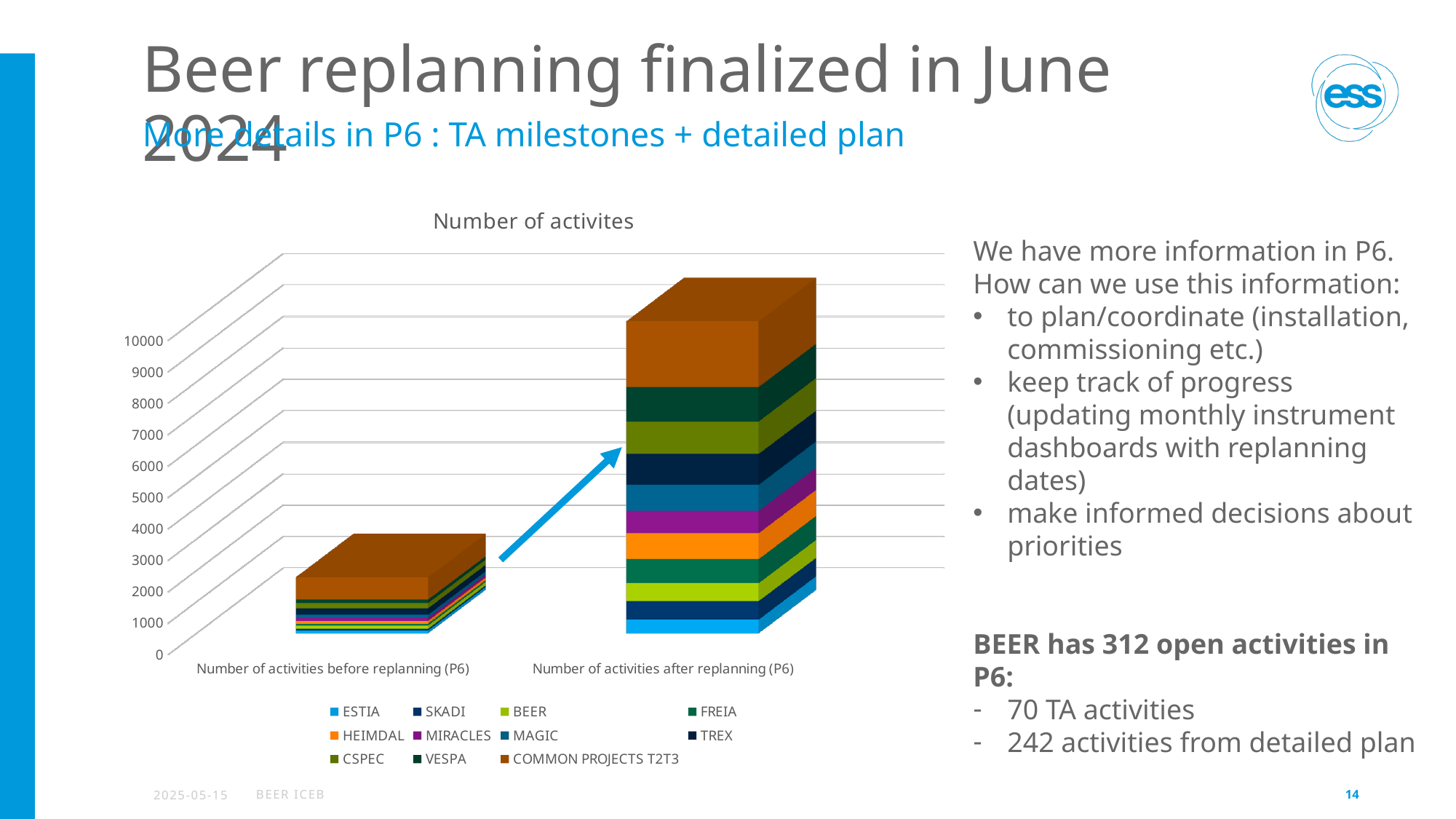
Is the total for 'Number of activities after replanning (P6)' greater or less than 5000? greater Which category has the shorter stacked bar? Number of activities before replanning (P6) Is the total number of activities larger before or after replanning? after replanning Is the total for 'Number of activities before replanning (P6)' greater or less than 5000? less How many series does the chart legend list? 11 Which category has the taller stacked bar? Number of activities after replanning (P6) Do the stacked totals rise or fall from the left category to the right category? rise What is the title of the chart? Number of activites Which series is listed first in the chart legend? ESTIA What is the highest value labelled on the vertical axis? 10000 What kind of chart is shown on the slide? stacked bar chart How many categories are plotted on the x axis of the chart? 2